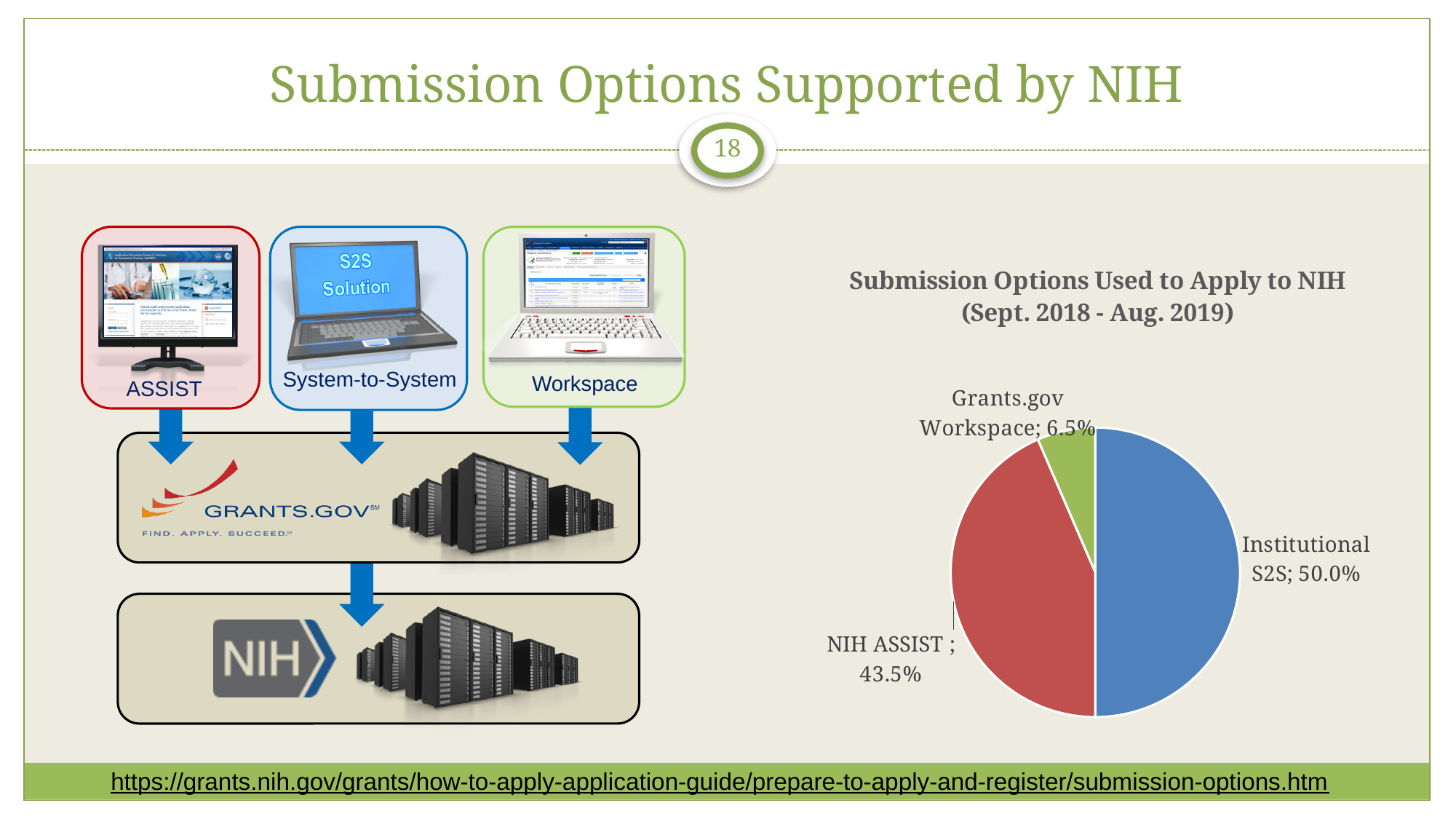
What is the difference between the shares of NIH ASSIST and Grants.gov Workspace? 37.0% What colour is the Institutional S2S slice? blue What is the title of the chart? Submission Options Used to Apply to NIH (Sept. 2018 - Aug. 2019) What share of the pie does Grants.gov Workspace have? 6.5% Which is larger, the share for NIH ASSIST or the share for Grants.gov Workspace? NIH ASSIST What share of the pie does Institutional S2S have? 50.0% What share of the pie does NIH ASSIST have? 43.5% What is the difference between the shares of Institutional S2S and NIH ASSIST? 6.5% Which submission option has the largest share? Institutional S2S Which submission option has the smallest share? Grants.gov Workspace How many slices does the pie chart have? 3 What type of chart is shown on the slide? pie chart